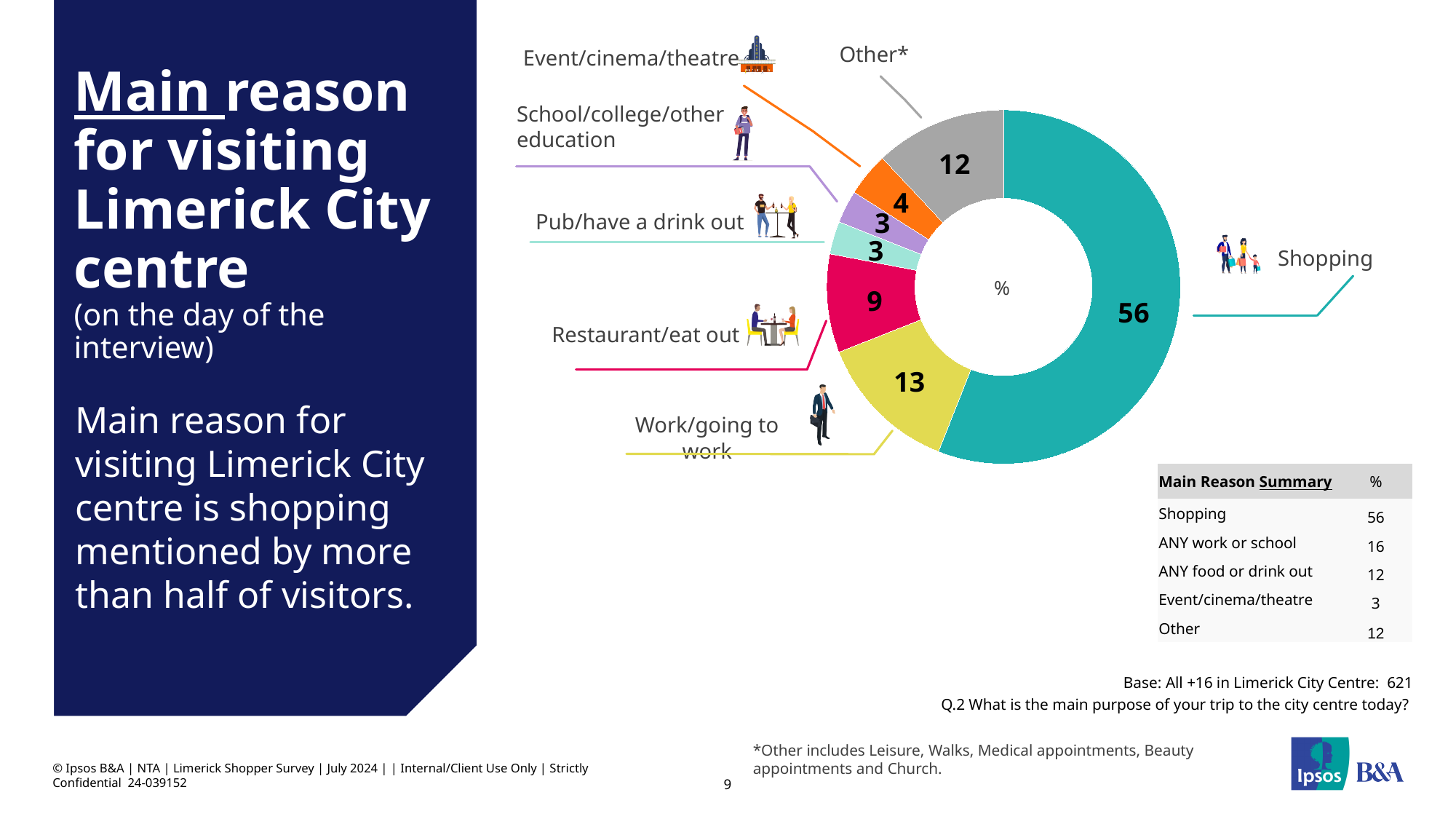
What is the value for Other* in the donut chart? 12 What is the value for Work/going to work in the donut chart? 13 What is the value for Shopping in the donut chart? 56 What is the difference between the values for Shopping and Work/going to work? 43 Which category has the largest share in the donut chart? Shopping How many categories are shown in the donut chart? 7 What is the value for Restaurant/eat out in the donut chart? 9 What kind of chart is shown on the slide? Pie chart (donut) What is the value for Event/cinema/theatre in the donut chart? 3 Which two categories in the donut chart both have a value of 3? School/college/other education and Event/cinema/theatre What is the difference between the values for Work/going to work and Restaurant/eat out? 4 Which is larger in the donut chart, Restaurant/eat out or Other*? Other*